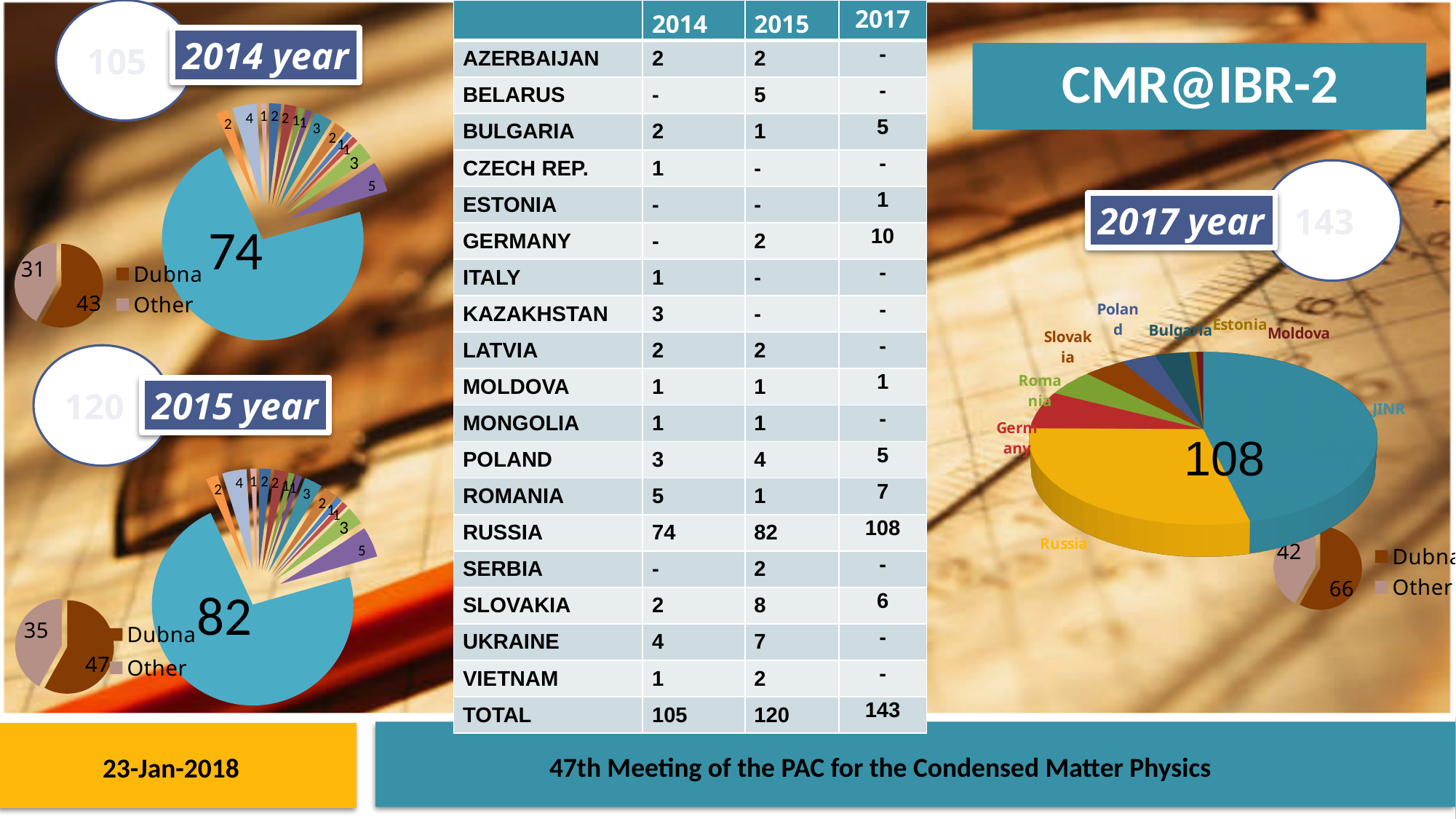
In the small Dubna/Other pie chart next to the 2015 year chart, what is the value for Dubna? 47 In the small Dubna/Other pie chart next to the 2014 year chart, what is the value for Dubna? 43 In the small Dubna/Other pie charts, what colour represents Dubna? Brown In the small Dubna/Other pie chart next to the 2015 year chart, which is larger, Dubna or Other? Dubna In the small Dubna/Other pie chart next to the 2017 year chart, what is the difference between the Dubna and Other values? 24 In the 2015 year pie chart, what value is printed on the largest slice? 82 In the small Dubna/Other pie chart next to the 2014 year chart, what is the value for Other? 31 In the 2014 year pie chart, what value is printed on the largest slice? 74 In the 2017 year pie chart, what value is printed on the largest slice? 108 How many entries does the legend of the small Dubna/Other pie charts list? 2 In the small Dubna/Other pie chart next to the 2017 year chart, what is the value for Other? 42 What kind of chart is the 2017 year chart? Pie chart